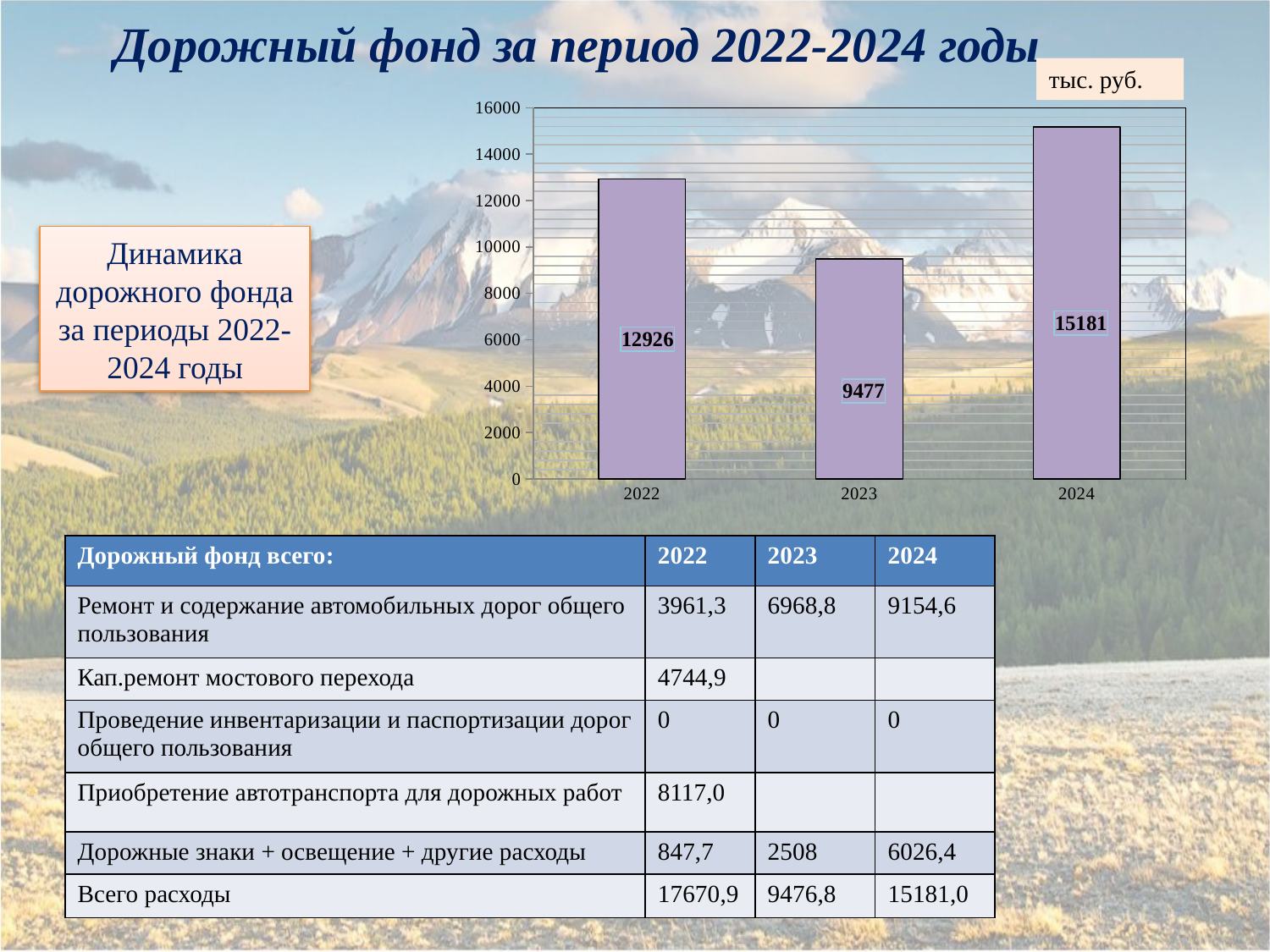
Which is larger, the value for 2022 or the value for 2024? 2024 How many bars are shown in the chart? 3 Is the value for 2023 greater or less than 10000? less Which year has the highest value in the chart? 2024 What kind of chart is shown on the slide? bar chart What is the value of the bar for 2022? 12926 Which year has the lowest value in the chart? 2023 What is the difference between the values for 2022 and 2023? 3449 What is the value of the bar for 2024? 15181 What is the value of the bar for 2023? 9477 What unit of measurement is indicated for the chart values? тыс. руб. What is the difference between the values for 2024 and 2023? 5704